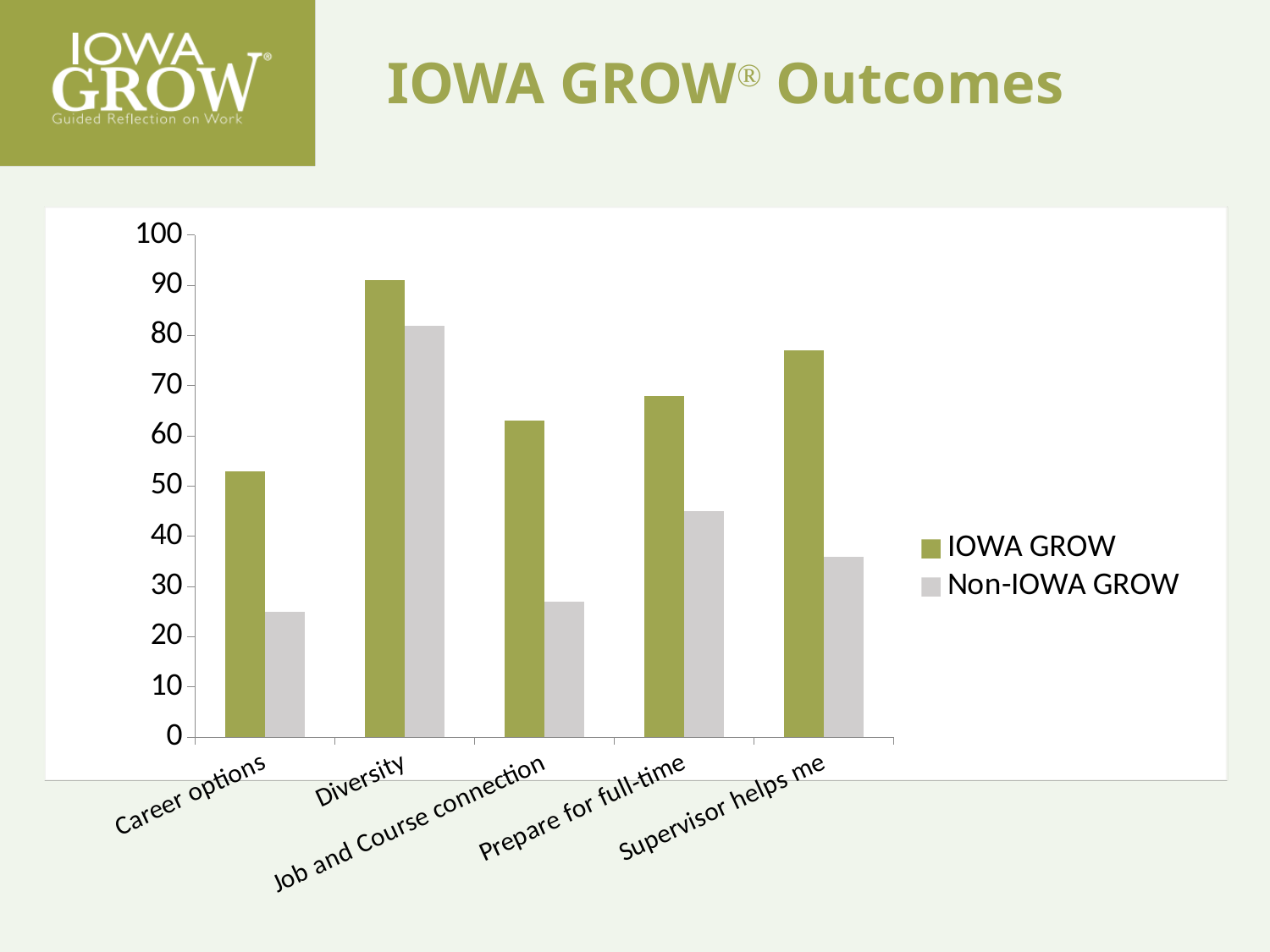
For Supervisor helps me, which series has the larger value, IOWA GROW or Non-IOWA GROW? IOWA GROW Which category has the lowest IOWA GROW value? Career options Is the Non-IOWA GROW value for Job and Course connection greater or less than 30? less How many series does the legend list? 2 Which category has the highest IOWA GROW value? Diversity What kind of chart is shown on the slide? bar chart Is the Non-IOWA GROW value for Prepare for full-time greater or less than 40? greater How many categories are shown on the x axis? 5 Which category has the lowest Non-IOWA GROW value? Career options Is the IOWA GROW value for Diversity greater or less than 80? greater Which series is shown in grey in the legend? Non-IOWA GROW